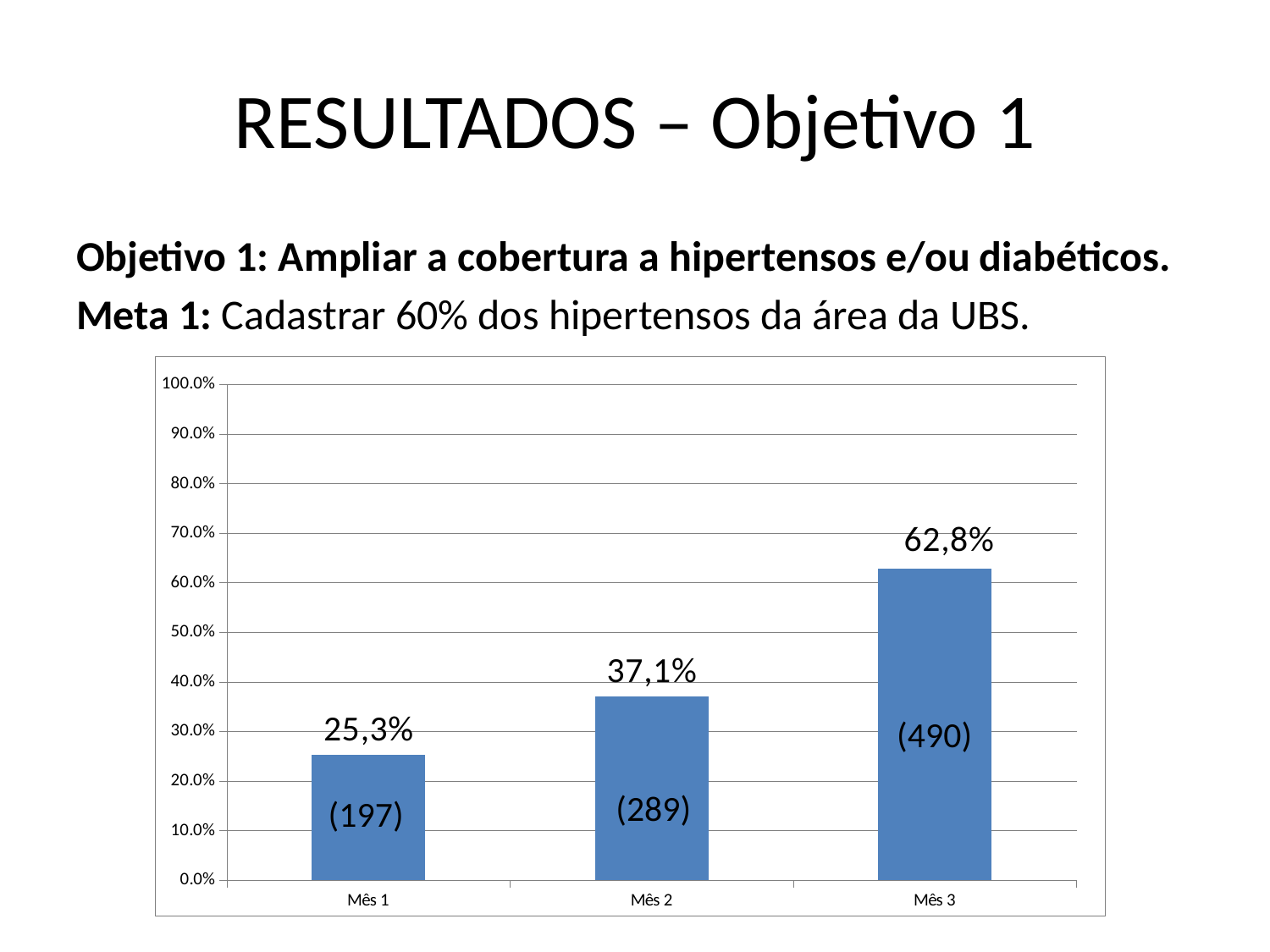
What is the difference between the values for Mês 3 and Mês 2? 25,7% What is the value for Mês 2? 37,1% How many months are shown on the x axis? 3 What is the value for Mês 3? 62,8% What number is shown in parentheses inside the bar for Mês 1? (197) What kind of chart is shown on the slide? Bar chart What number is shown in parentheses inside the bar for Mês 3? (490) Which month has the lowest value? Mês 1 Which is larger, the value for Mês 2 or the value for Mês 1? Mês 2 Which month has the highest value? Mês 3 What is the value for Mês 1? 25,3% Is the value for Mês 3 greater or less than 60.0%? greater